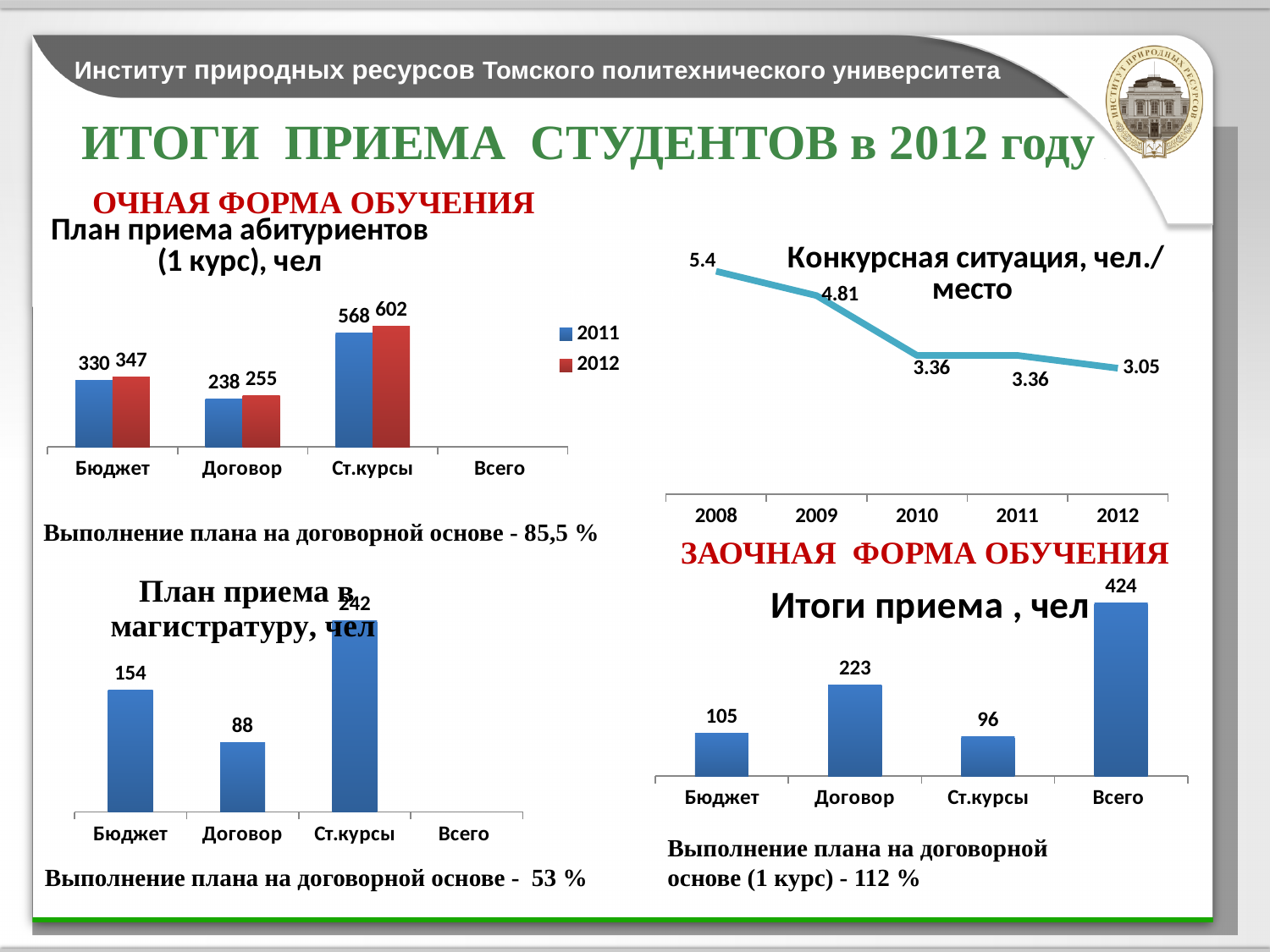
In the chart 'Итоги приема, чел', what is the value for Всего? 424 In the chart 'Конкурсная ситуация, чел./место', what is the value for 2009? 4.81 In the chart 'Конкурсная ситуация, чел./место', which year has the highest value? 2008 In the chart 'План приема абитуриентов (1 курс), чел', what is the 2011 value for Договор? 238 In the chart 'План приема в магистратуру, чел', what is the value for Ст.курсы? 242 In the chart 'План приема абитуриентов (1 курс), чел', what is the 2012 value for Ст.курсы? 602 In the chart 'Конкурсная ситуация, чел./место', do the values rise or fall from 2008 to 2012? Fall What kind of chart is 'Конкурсная ситуация, чел./место'? Line chart In the chart 'Итоги приема, чел', which is larger, Бюджет or Договор? Договор In the chart 'План приема абитуриентов (1 курс), чел', how many series does the legend list? 2 In the chart 'План приема абитуриентов (1 курс), чел', what is the difference between the 2012 and 2011 values for Бюджет? 17 In the chart 'План приема в магистратуру, чел', which category has the lowest value? Договор